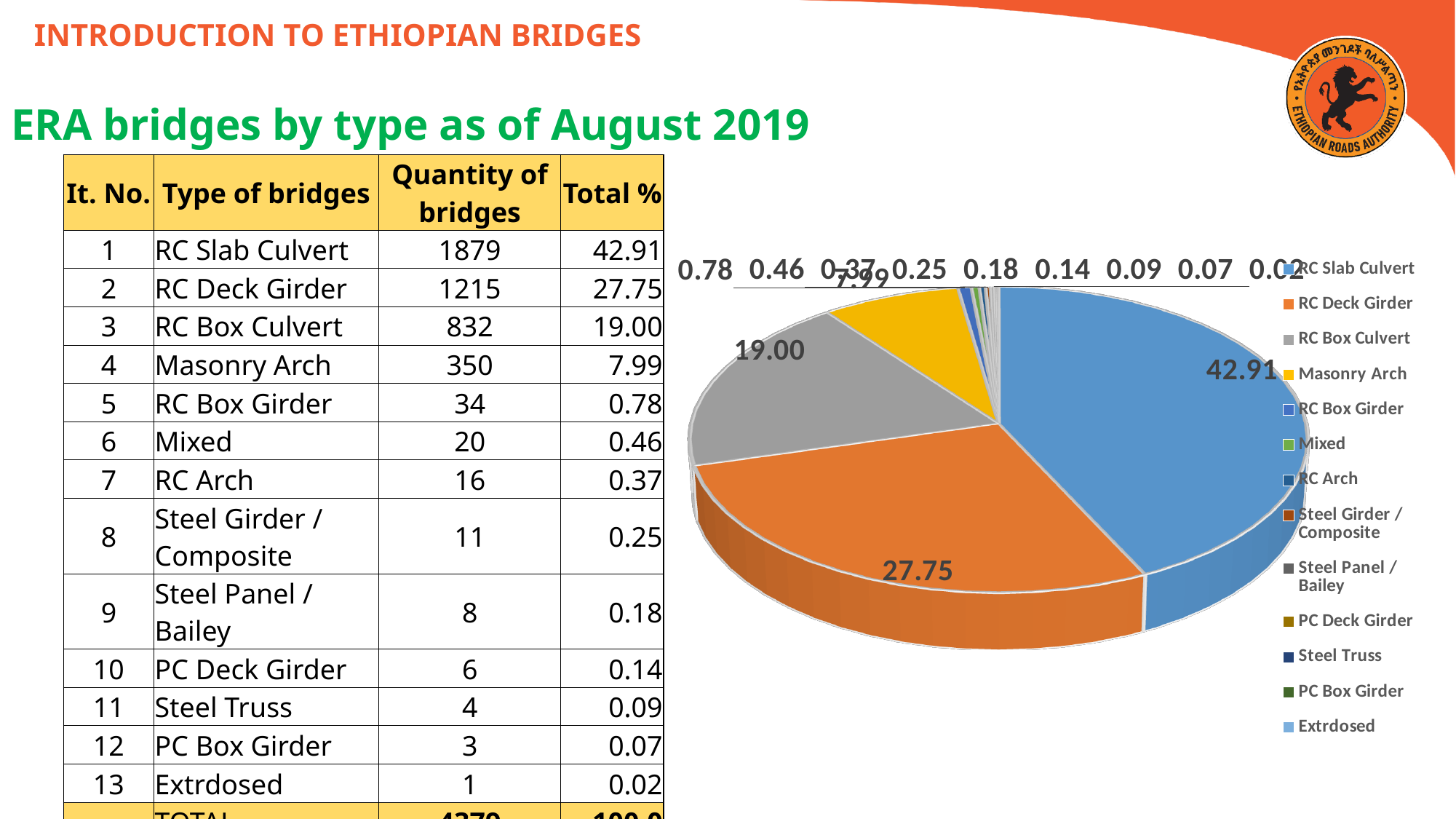
What value is labelled on the RC Slab Culvert slice of the pie chart? 42.91 What colour is the RC Deck Girder slice in the pie chart? orange How many entries does the pie chart's legend list? 13 What is the combined value of the RC Slab Culvert and RC Box Culvert slices in the pie chart? 61.91 What value is labelled on the RC Deck Girder slice of the pie chart? 27.75 What value is labelled on the Masonry Arch slice of the pie chart? 7.99 What kind of chart is shown on the slide? pie chart Which bridge type has the smallest slice in the pie chart? Extrdosed What is the difference between the RC Slab Culvert and RC Deck Girder values in the pie chart? 15.16 Which bridge type has the largest slice in the pie chart? RC Slab Culvert What value is labelled on the RC Box Culvert slice of the pie chart? 19.00 In the pie chart, which slice is larger: RC Deck Girder or RC Box Culvert? RC Deck Girder